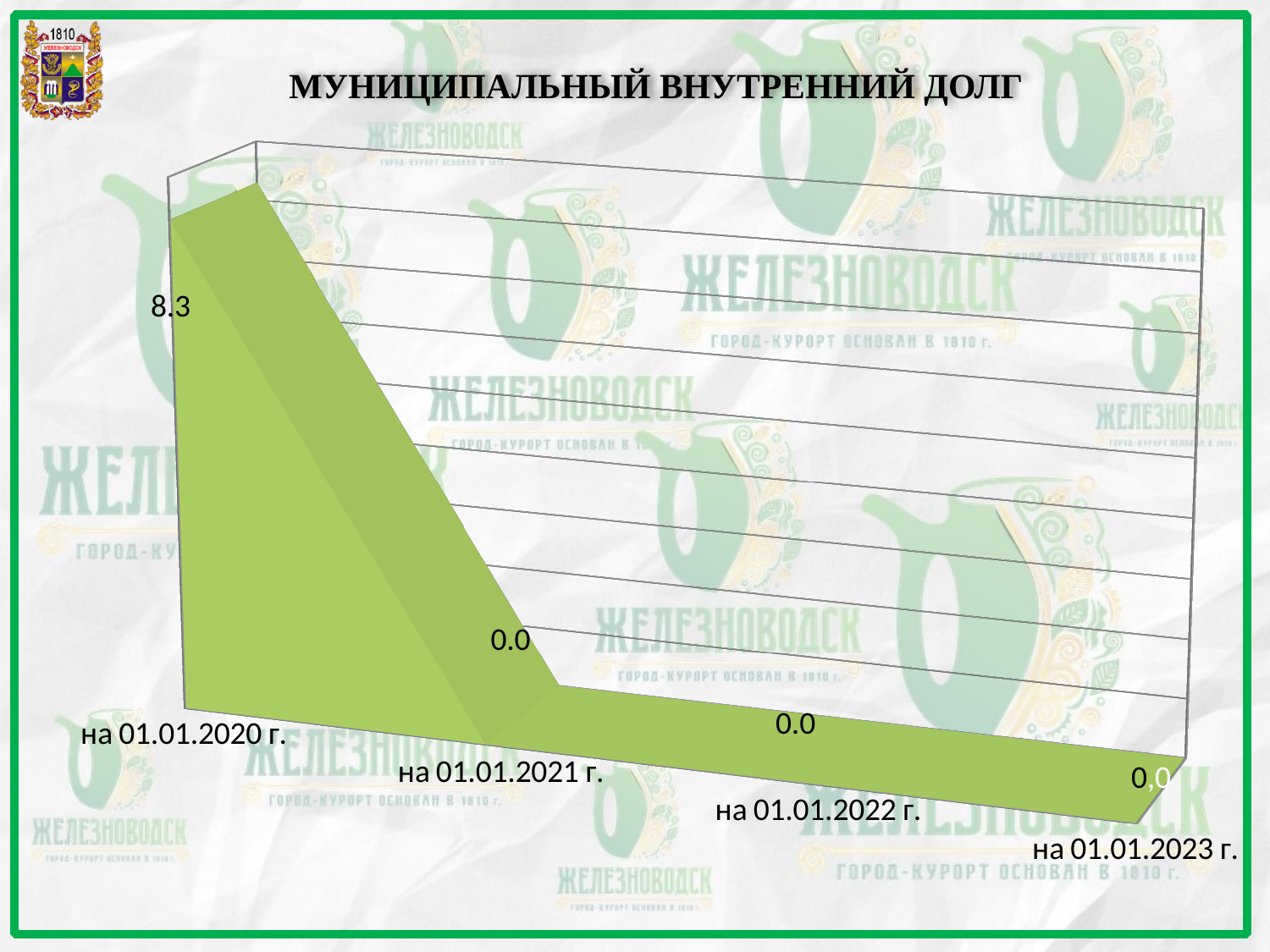
What is the difference between the values for на 01.01.2020 г. and на 01.01.2021 г.? 8.3 Which date has the highest value? на 01.01.2020 г. What is the title of the chart? МУНИЦИПАЛЬНЫЙ ВНУТРЕННИЙ ДОЛГ What is the total of the values for на 01.01.2021 г., на 01.01.2022 г. and на 01.01.2023 г.? 0.0 How many dates are plotted on the chart? 4 What is the value for на 01.01.2020 г.? 8.3 What kind of chart is shown on the slide? area chart What colour is the plotted area on the chart? green What is the value for на 01.01.2022 г.? 0.0 Do the values rise or fall from на 01.01.2020 г. to на 01.01.2021 г.? fall What is the value for на 01.01.2021 г.? 0.0 Which is larger, the value for на 01.01.2020 г. or the value for на 01.01.2022 г.? на 01.01.2020 г.